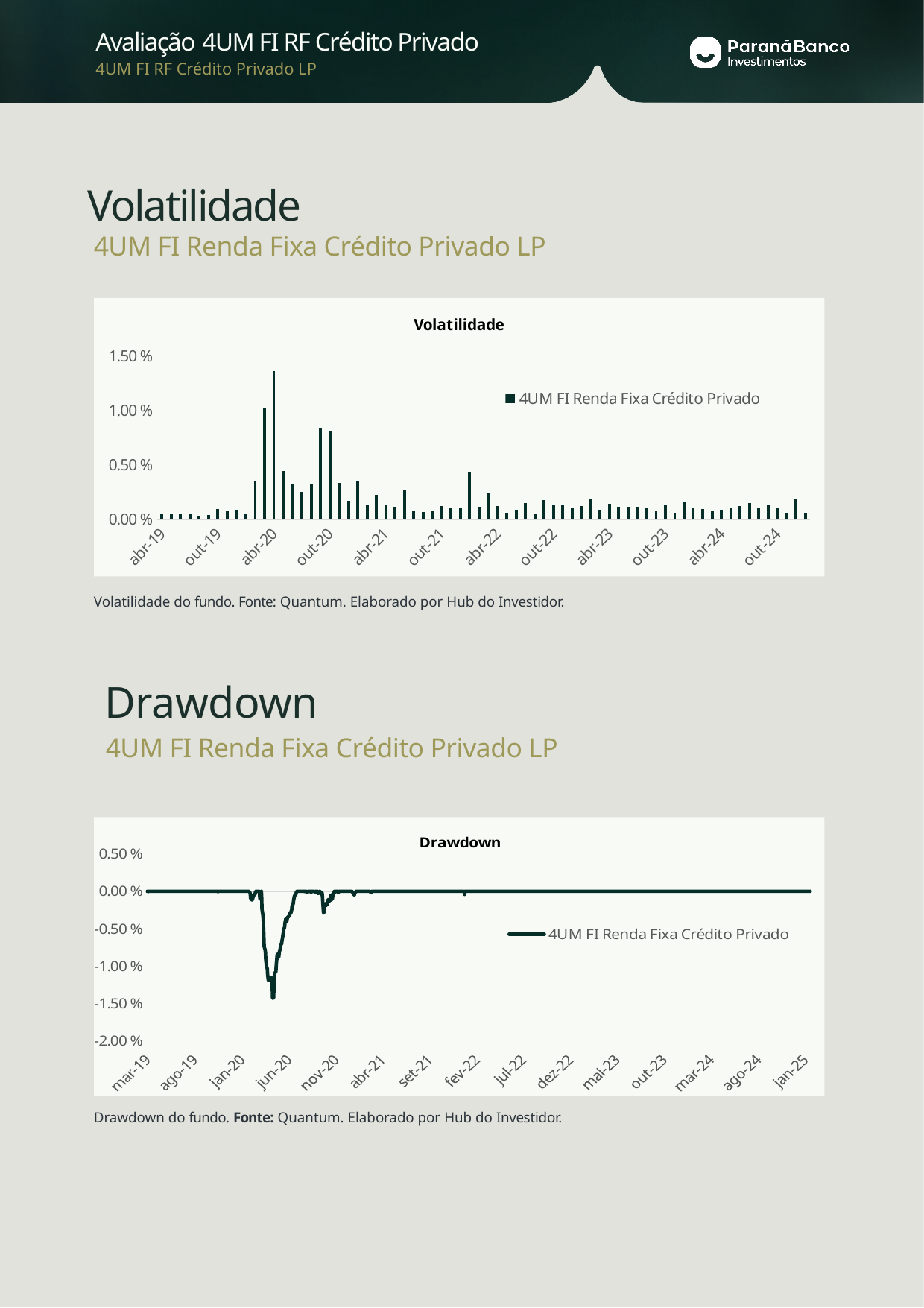
In the Volatilidade chart, do the bars generally rise or fall from out-20 to out-24? fall In the Volatilidade chart, is the tallest bar greater or less than 1.50%? less How many x-axis labels are shown on the Drawdown chart? 15 In the Drawdown chart, near which x-axis label does the line reach its lowest point? jun-20 In the Drawdown chart, is the lowest point of the line greater or less than -1.50%? greater In the Drawdown chart, is the lowest point of the line greater or less than -1.00%? less How many series does the legend of the Volatilidade chart list? 1 How many x-axis labels are shown on the Volatilidade chart? 12 What kind of chart is the Volatilidade chart? bar chart What kind of chart is the Drawdown chart? line chart What is the series name shown in the legend of the Drawdown chart? 4UM FI Renda Fixa Crédito Privado